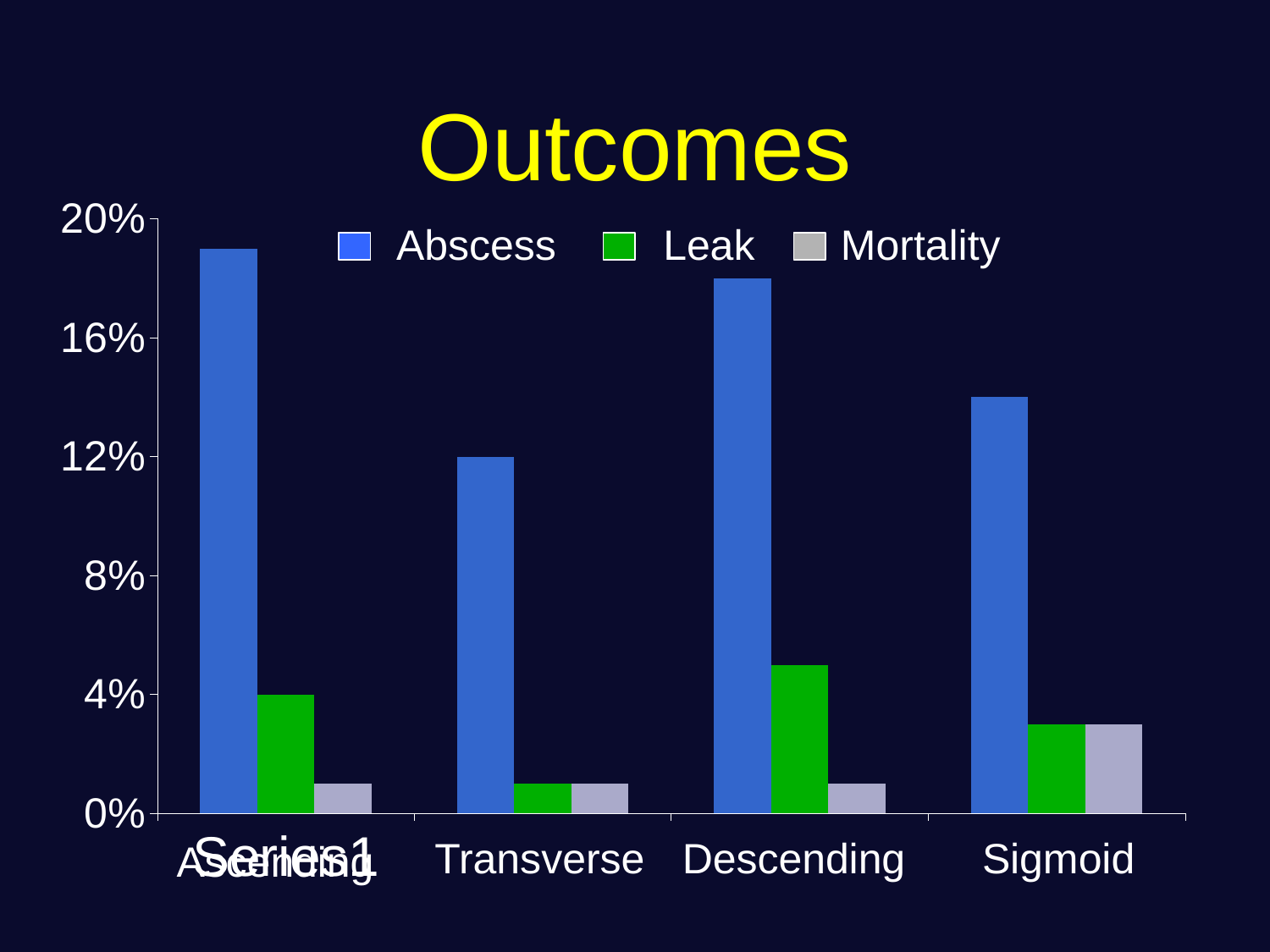
Is the Leak value for Descending greater or less than 4%? greater What is the title of the chart? Outcomes Which category has the highest Abscess value? Ascending Is the Abscess value for Descending greater or less than 16%? greater How many series does the legend list? 3 What is the Leak value for Ascending? 4% How many categories are shown on the x axis? 4 Which category has the lowest Abscess value? Transverse Is the Abscess value for Sigmoid greater or less than 16%? less What kind of chart is shown on the slide? bar chart What is the Abscess value for Transverse? 12% Which is larger, the Abscess value for Sigmoid or the Abscess value for Transverse? Sigmoid